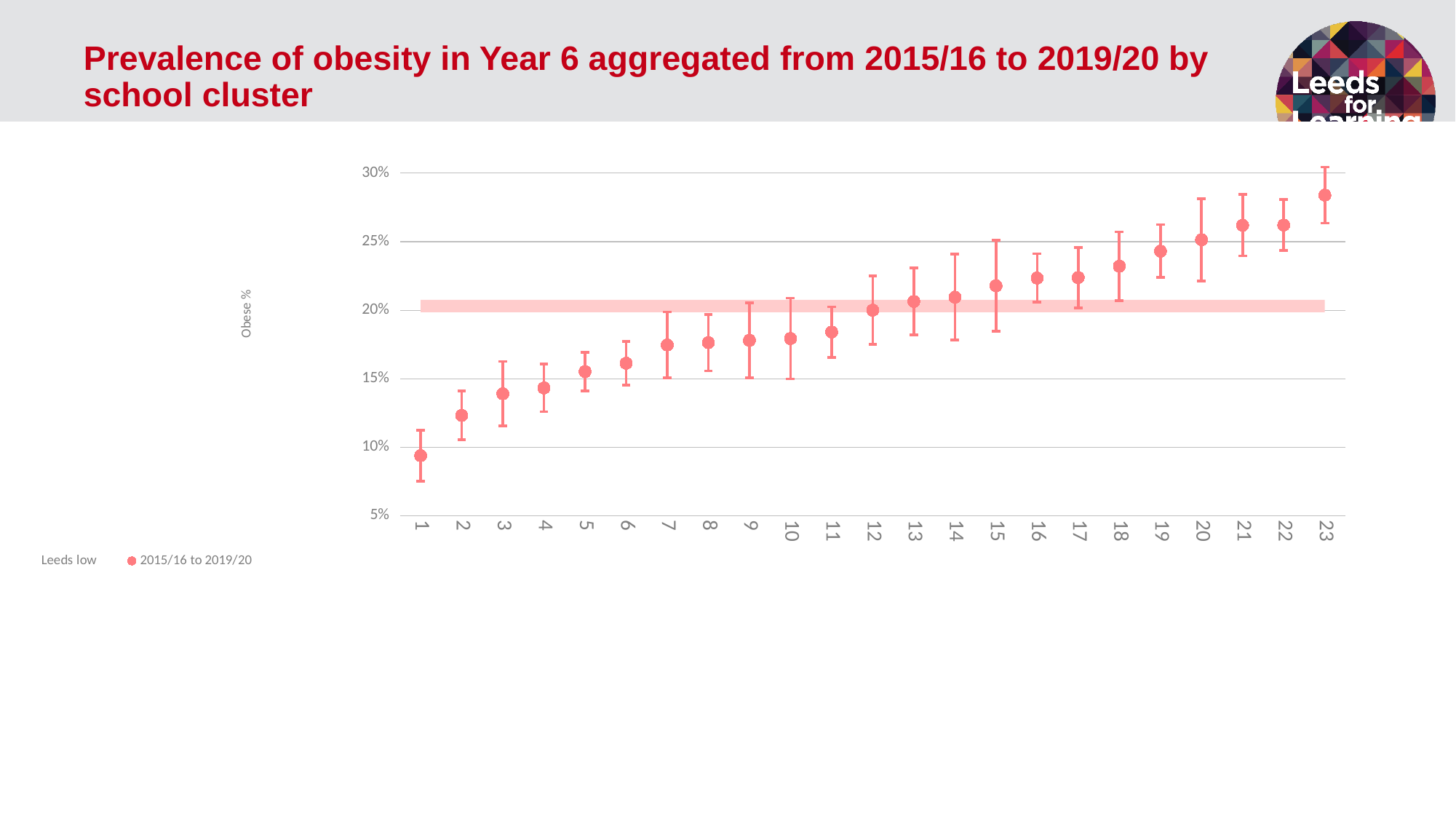
Is the value for cluster 1 greater or less than 10%? less How many school clusters are plotted on the x axis? 23 Which school cluster has the highest obesity prevalence? 23 What is the label on the y axis? Obese % Which has a higher obesity prevalence, cluster 3 or cluster 16? cluster 16 Is the value for cluster 7 greater or less than 15%? greater Is the value for cluster 23 greater or less than 25%? greater How many entries does the legend list? 2 Do the plotted values rise or fall as the cluster number increases along the x axis? rise Which school cluster has the lowest obesity prevalence? 1